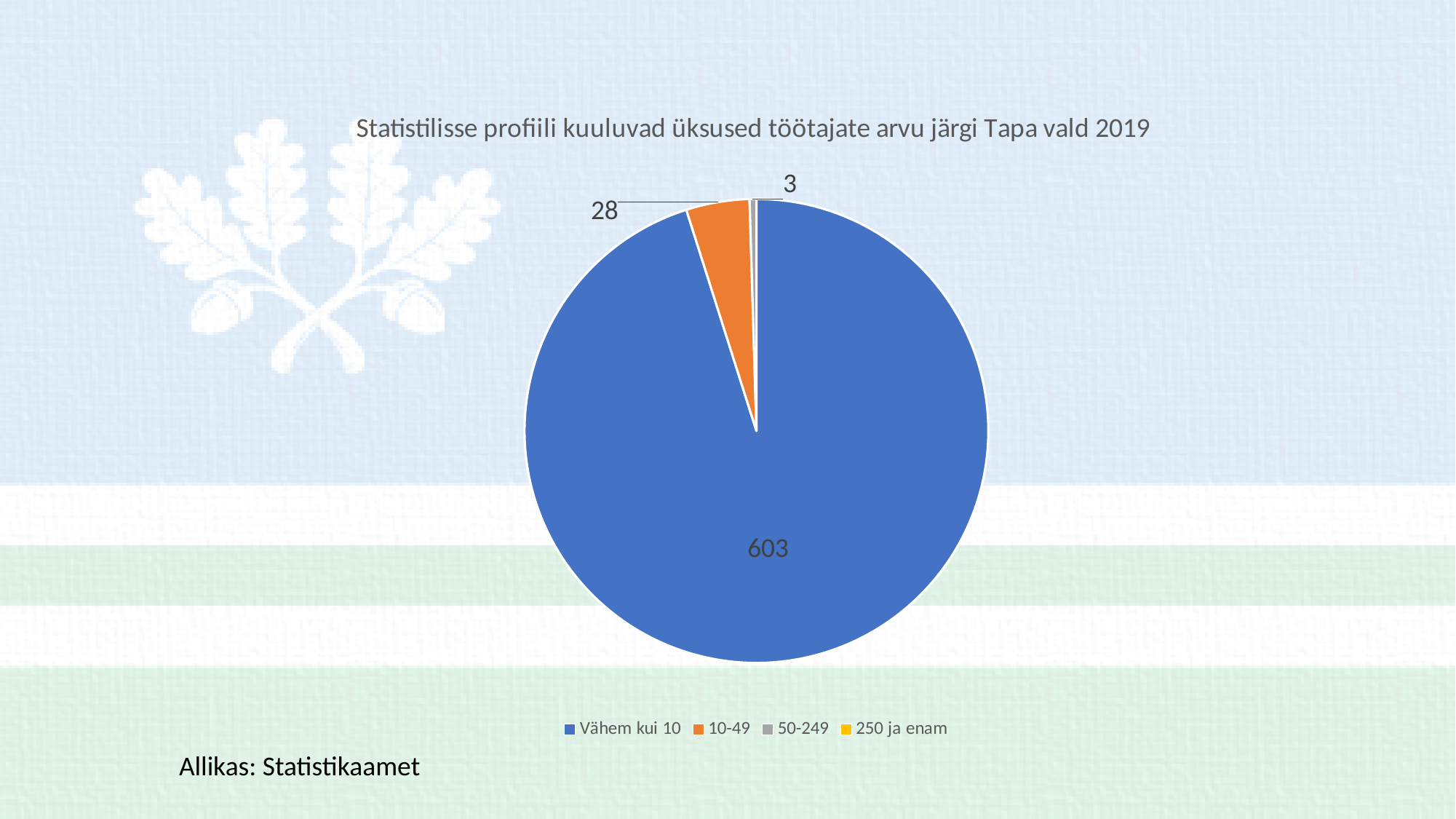
What is the value for the '10-49' slice? 28 What colour is the 'Vähem kui 10' slice? blue What is the value for the 'Vähem kui 10' slice? 603 What is the title of the chart? Statistilisse profiili kuuluvad üksused töötajate arvu järgi Tapa vald 2019 What is the value for the '50-249' slice? 3 What type of chart is shown on the slide? pie chart How many categories does the legend list? 4 What is the difference between the values for 'Vähem kui 10' and '10-49'? 575 What is the difference between the values for '10-49' and '50-249'? 25 Which category has the largest slice of the pie? Vähem kui 10 Which of the labelled slices is larger, '10-49' or '50-249'? 10-49